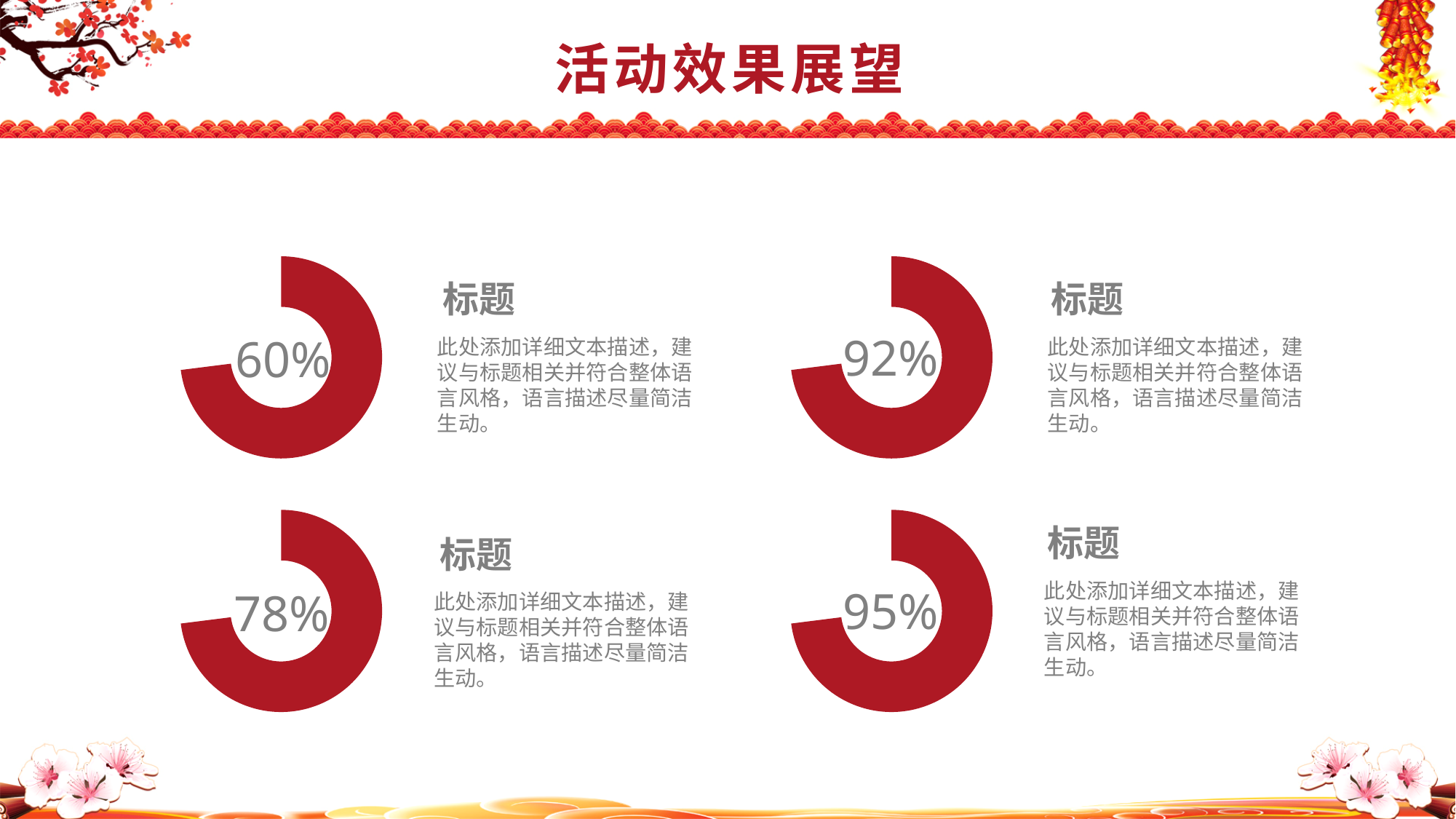
What percentage is shown in the top-left donut chart? 60% Which is larger, the percentage in the bottom-left donut chart or the top-left donut chart? bottom-left (78%) What percentage is shown in the bottom-right donut chart? 95% What percentage is shown in the top-right donut chart? 92% How many donut charts are on the slide? 4 What kind of chart is used to display the percentages on this slide? donut chart What is the difference between the percentages in the bottom-right and bottom-left donut charts? 17% What is the difference between the percentages in the top-right and top-left donut charts? 32% Which of the four donut charts shows the lowest percentage? top-left (60%) Which of the four donut charts shows the highest percentage? bottom-right (95%) What percentage is shown in the bottom-left donut chart? 78% What colour is the filled portion of each donut chart? red